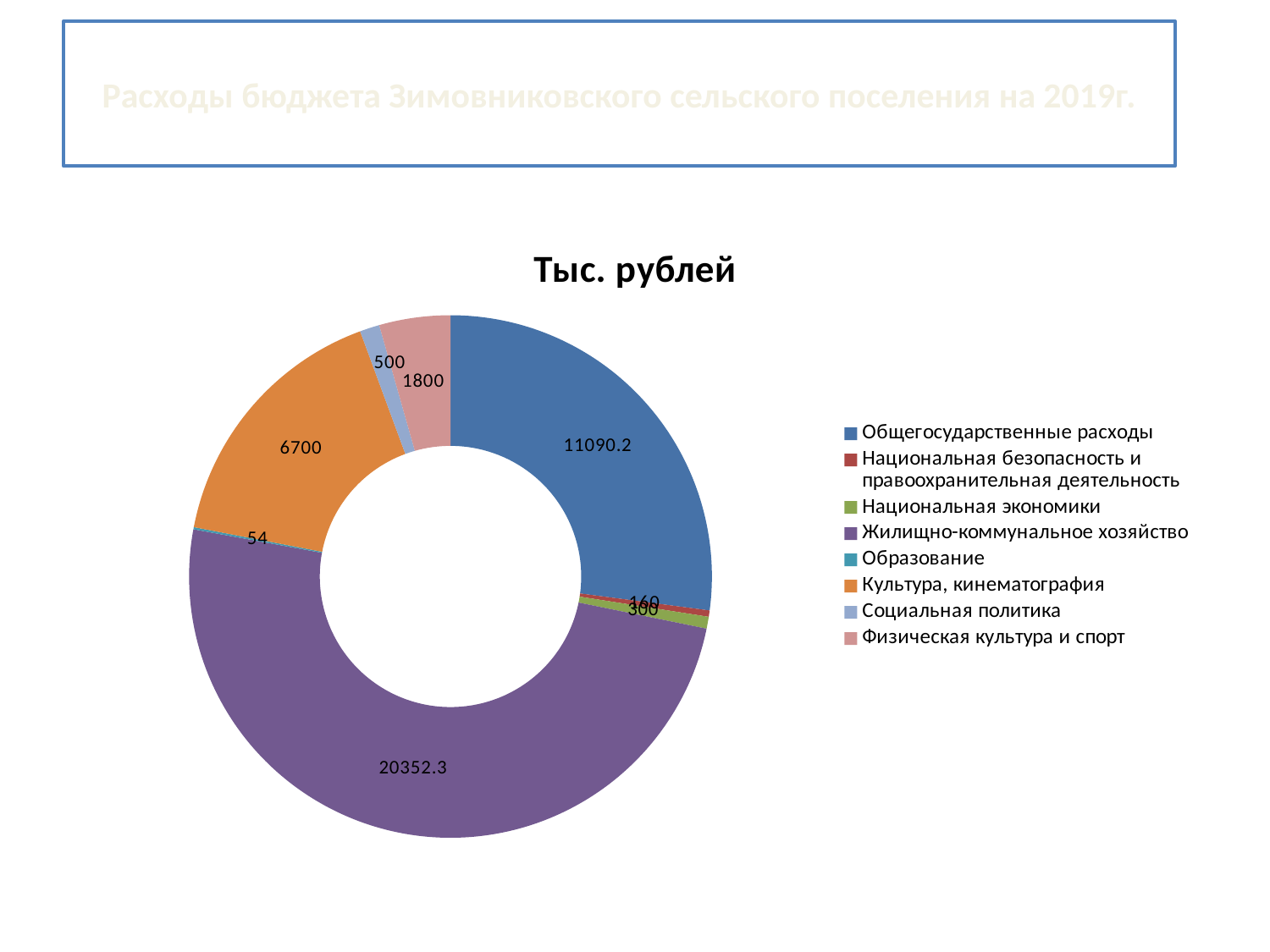
What is the value for Культура, кинематография? 6700 What is the value for Общегосударственные расходы? 11090.2 What is the value for Образование? 54 What is the chart's title? Тыс. рублей How many categories does the legend list? 8 What is the value for Жилищно-коммунальное хозяйство? 20352.3 What is the value for Социальная политика? 500 Which is larger, Культура, кинематография or Физическая культура и спорт? Культура, кинематография What type of chart is shown on the slide? doughnut chart Which category has the largest slice? Жилищно-коммунальное хозяйство What is the difference between Жилищно-коммунальное хозяйство and Общегосударственные расходы? 9262.1 What is the value for Физическая культура и спорт? 1800